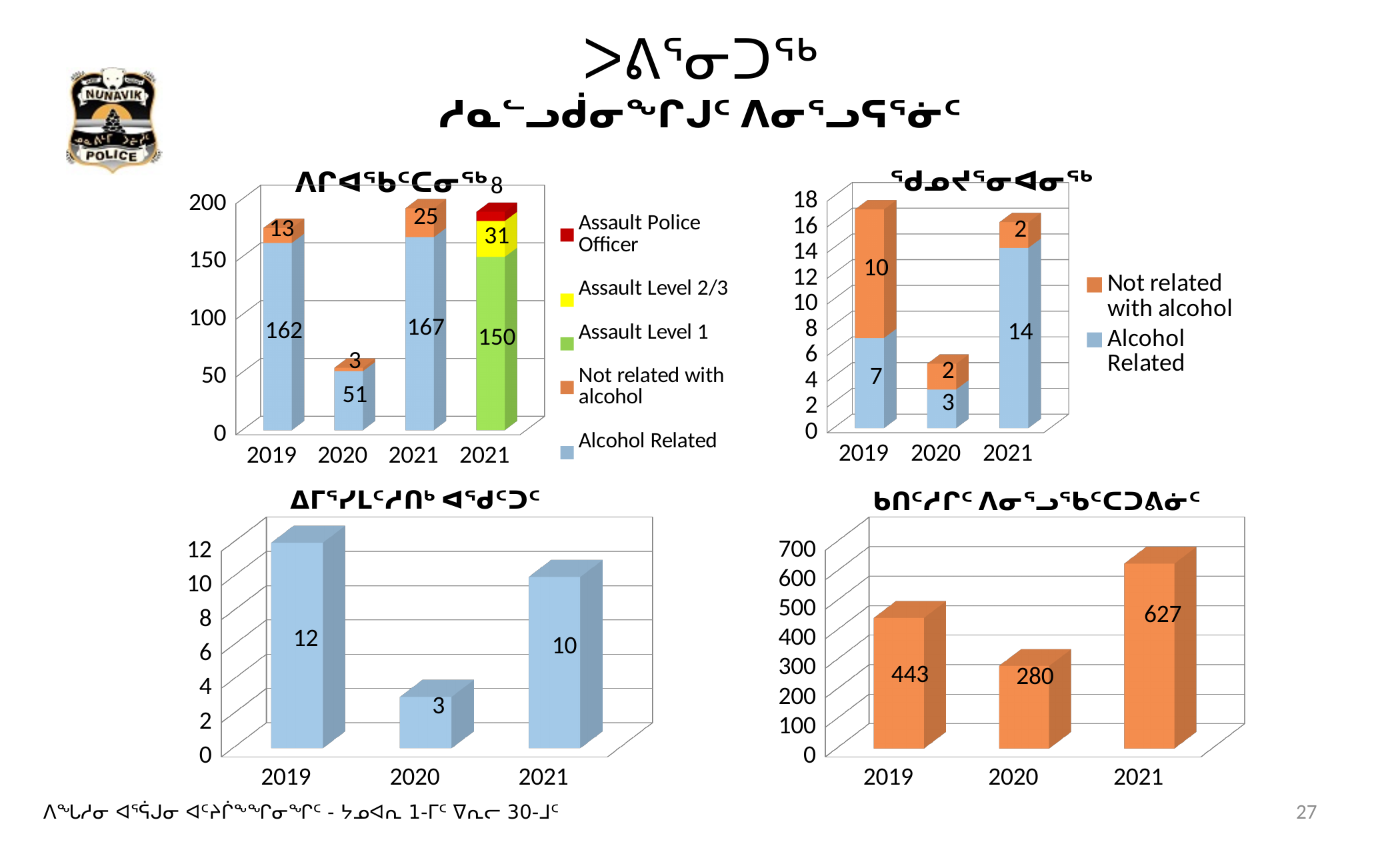
What kind of chart is the bottom-right chart? bar chart In the bottom-right chart, which year has the lowest value? 2020 In the top-left chart, what is the Alcohol Related value for 2020? 51 In the bottom-right chart, what is the value for 2021? 627 In the top-left chart, what is the Assault Level 2/3 value for the second 2021 bar? 31 In the bottom-right chart, what is the difference between the values for 2021 and 2019? 184 In the top-right chart, what is the Alcohol Related value for 2021? 14 In the bottom-left chart, what is the value for 2019? 12 In the bottom-left chart, how many years are shown on the x axis? 3 In the top-right chart, how many series does the legend list? 2 In the top-right chart, what is the total of the stacked bar for 2019? 17 In the bottom-left chart, which year has the highest value? 2019